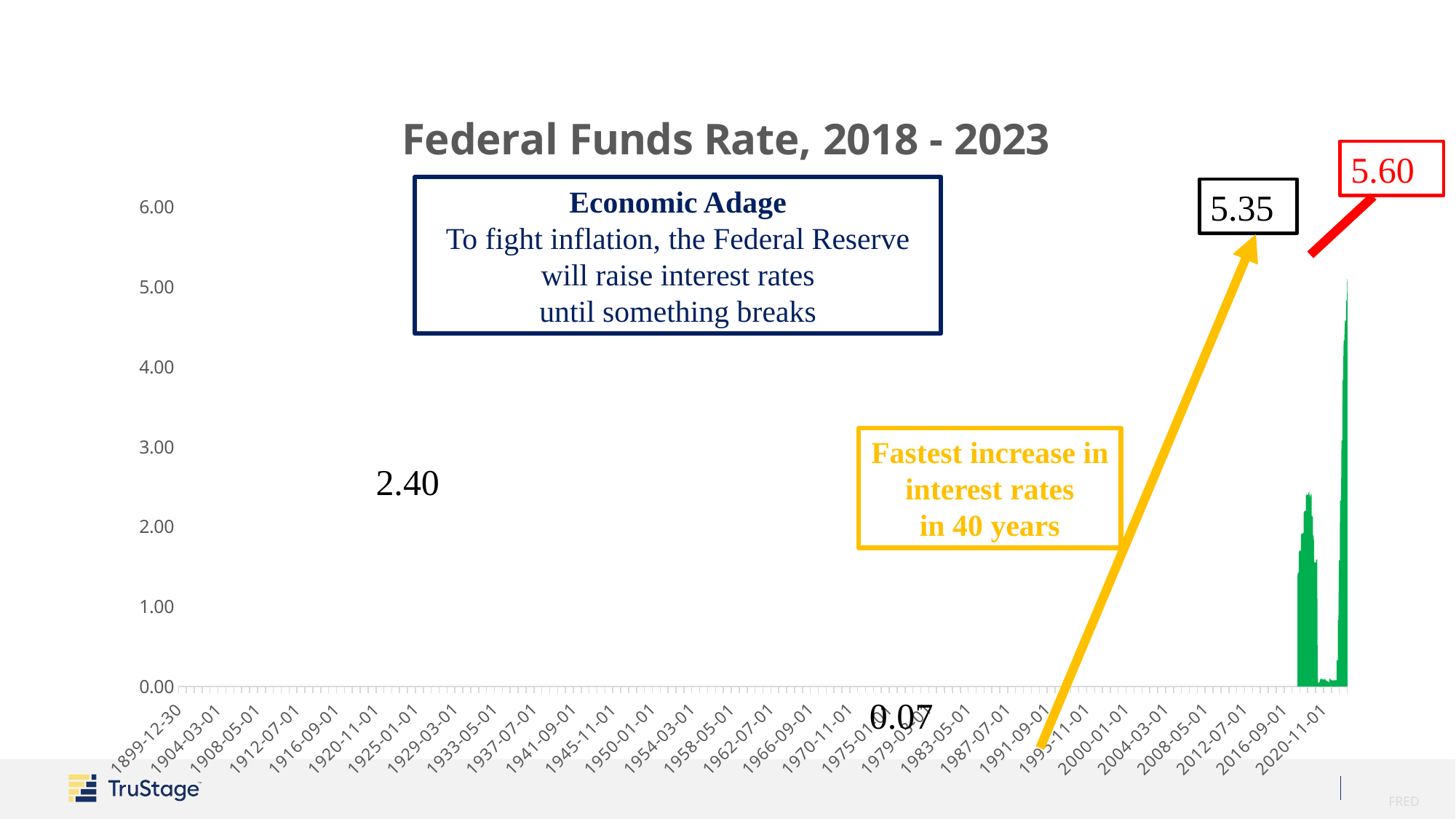
Is the earlier green peak (around 2019) greater or less than 3.00? less Which labelled value is larger, 2.40 or 5.35? 5.35 Does the plotted rate rise or fall at the far right end of the chart? rise What is the difference between the values 5.60 and 5.35 labelled on the chart? 0.25 Is the peak of the green data at the far right of the chart greater or less than 5.00? greater What is the highest value labelled on the chart's vertical axis? 6.00 What value is shown in the black-outlined box at the top right of the chart? 5.35 What is the title of the chart? Federal Funds Rate, 2018 - 2023 What is the difference between the labelled values 5.35 and 0.07? 5.28 What colour is the plotted data in the chart? Green What value is shown in the red-outlined box at the top right of the chart? 5.60